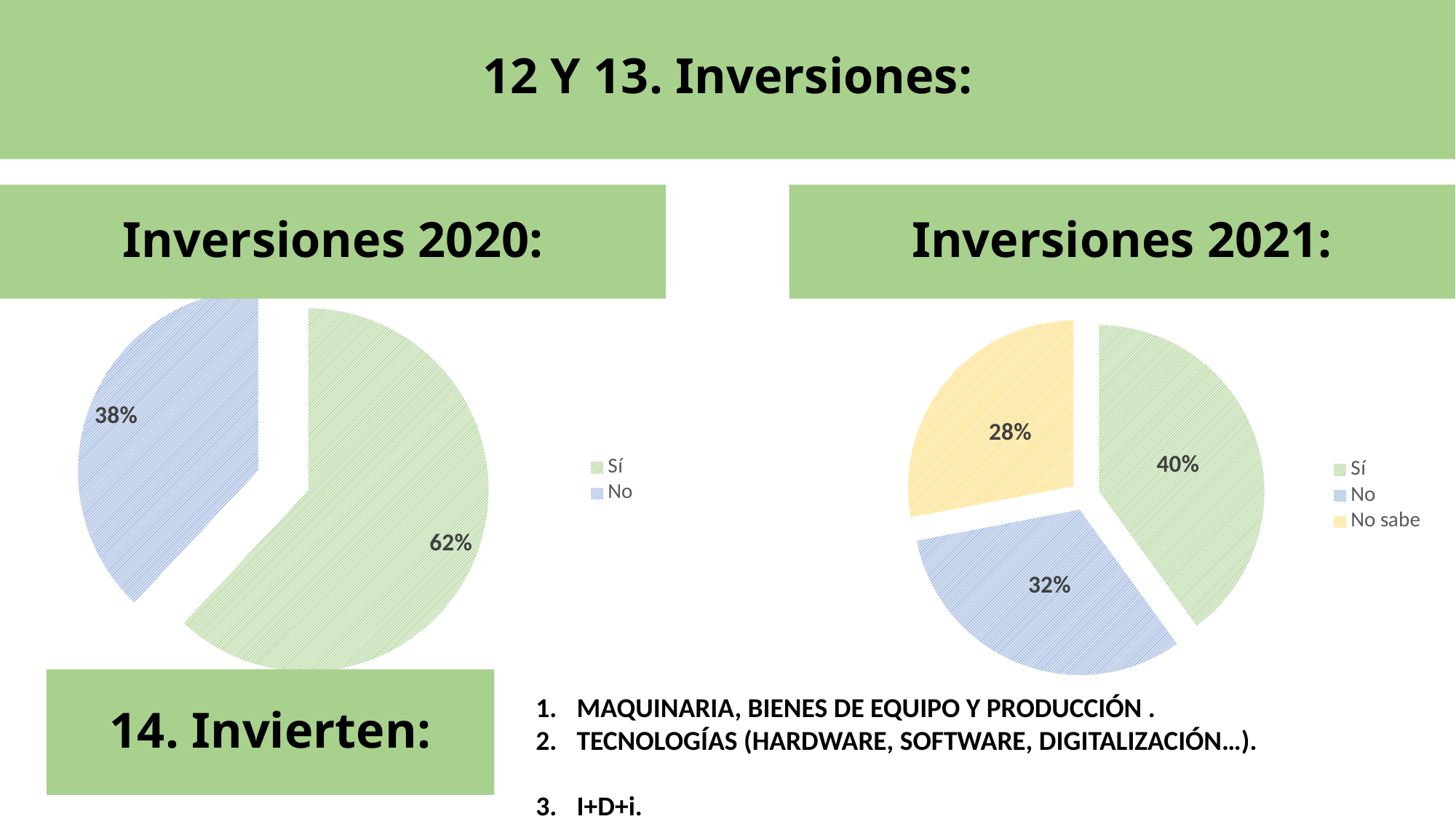
In the Inversiones 2021 chart, what share is labelled for Sí? 40% In the Inversiones 2021 chart, what share is labelled for No sabe? 28% In the Inversiones 2021 chart, which is larger, No or No sabe? No In the Inversiones 2020 chart, what share is labelled for Sí? 62% In the Inversiones 2020 chart, what share is labelled for No? 38% In the Inversiones 2021 chart, which category has the smallest slice? No sabe What kind of chart is the Inversiones 2020 chart? Pie chart In the Inversiones 2020 chart, what is the difference in percentage points between Sí and No? 24 How many entries does the legend of the Inversiones 2020 chart list? 2 How many categories does the Inversiones 2021 chart show? 3 In the Inversiones 2021 chart, which category has the largest slice? Sí In the Inversiones 2021 chart, what colour is the No sabe slice? Yellow